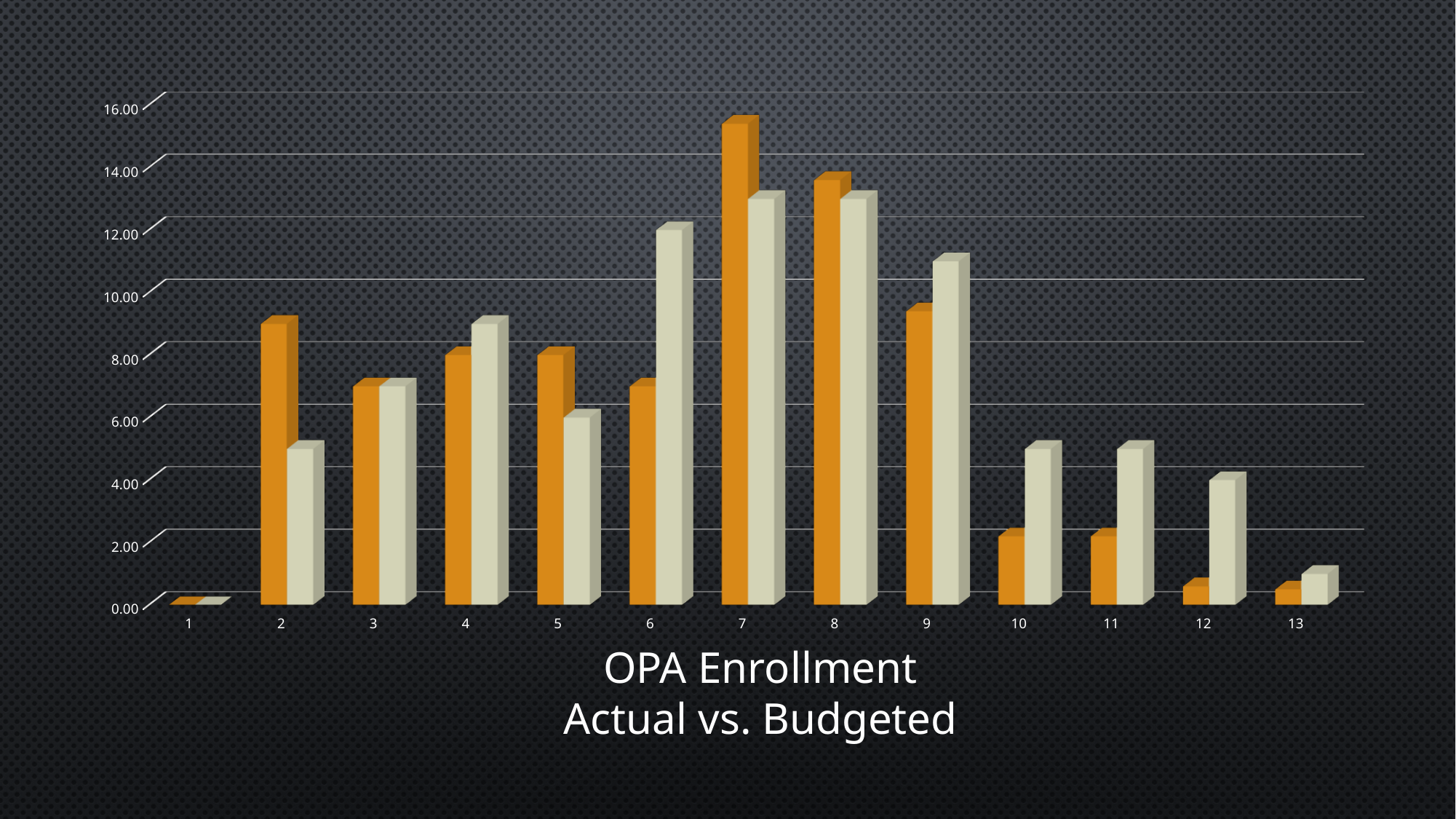
How many categories are shown along the x axis of the chart? 13 How many bars are plotted for each category on the chart? 2 For category 6, which bar is taller, the orange bar or the light-coloured bar? the light-coloured bar Is the orange bar for category 7 greater or less than 14.00? greater Do the orange bars rise or fall from category 9 to category 13? fall What is the title of the chart? OPA Enrollment Actual vs. Budgeted Which category has the tallest orange bar? 7 For category 2, which bar is taller, the orange bar or the light-coloured bar? the orange bar Is the orange bar for category 10 greater or less than 4.00? less Is the light-coloured bar for category 9 greater or less than 10.00? greater What kind of chart is shown on the slide? bar chart